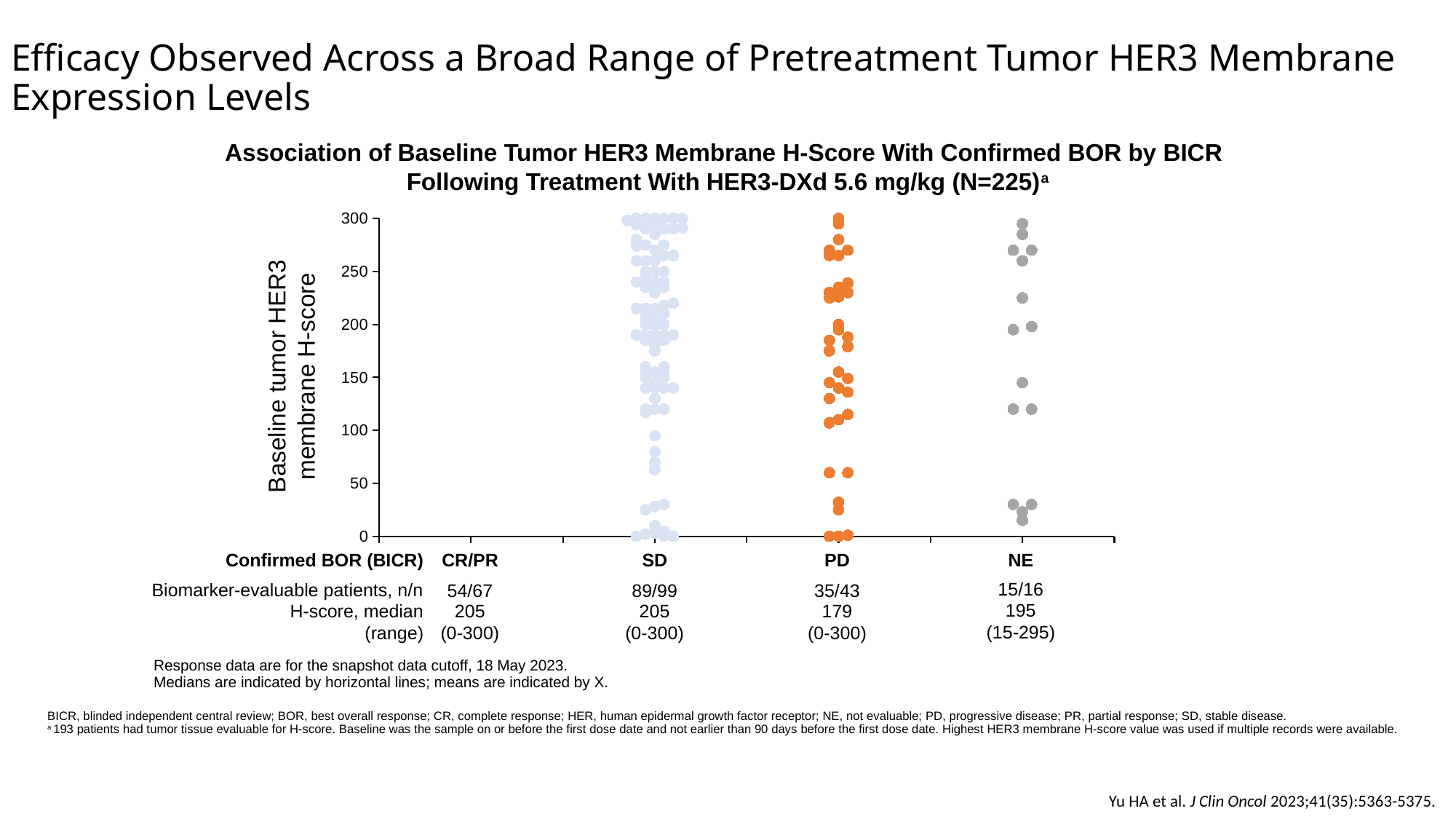
How many biomarker-evaluable patients (n/n) are listed for the SD group? 89/99 What is the label of the y axis? Baseline tumor HER3 membrane H-score What kind of chart is shown on the slide? Dot plot (scatter plot) What is the difference between the median H-score of the SD group and the PD group? 26 What is the highest value shown on the y axis? 300 How many confirmed BOR categories are shown along the x axis? 4 Is the median H-score for the PD group greater or less than 200? less What is the median H-score for the PD group? 179 What is the H-score range shown for the NE group? (15-295) Which confirmed BOR group has the lowest median H-score? PD What is the median H-score for the NE group? 195 Which group has a higher median H-score, NE or PD? NE